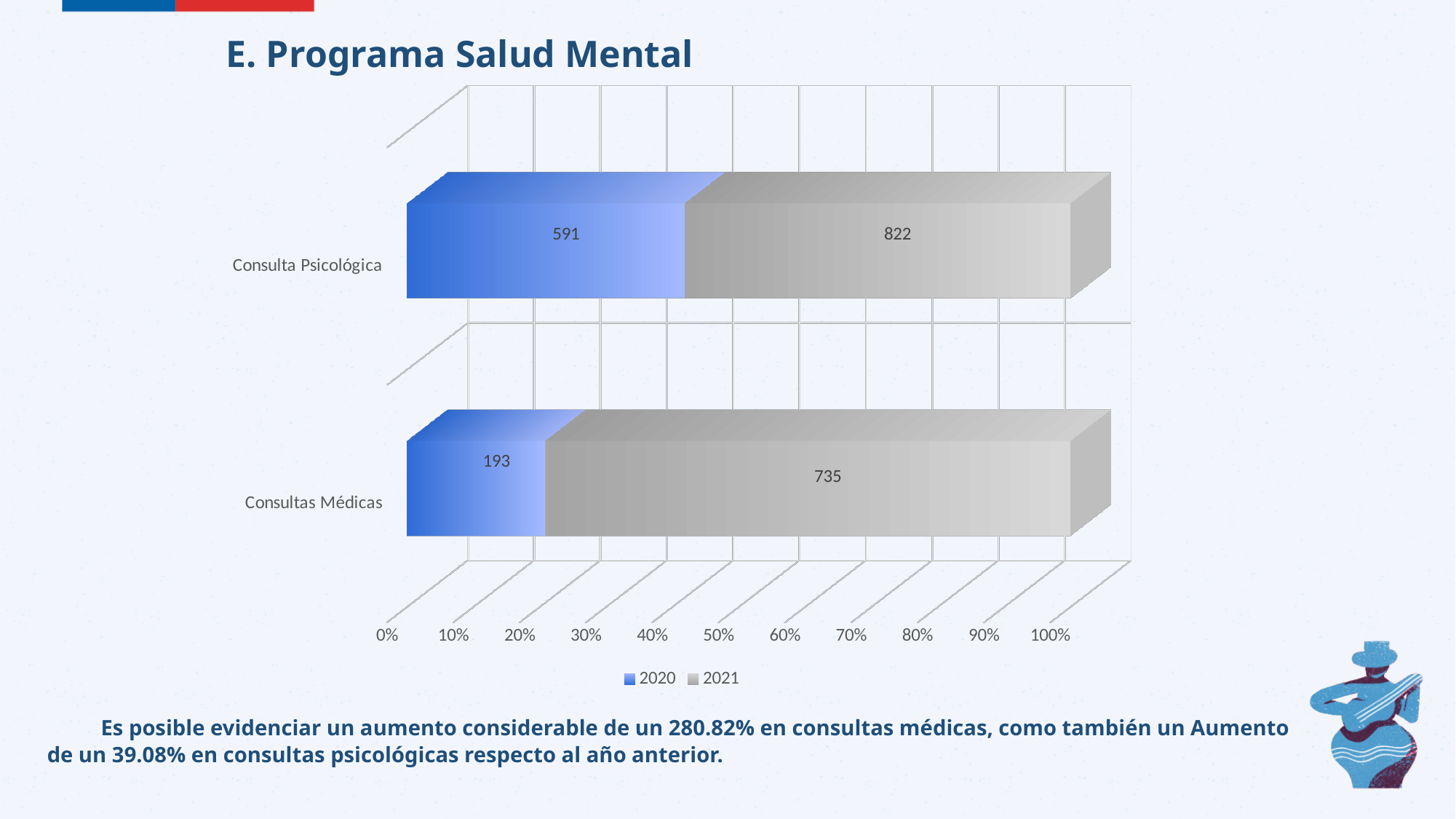
What is the difference between the 2021 and 2020 values for Consulta Psicológica? 231 What is the difference between the 2021 and 2020 values for Consultas Médicas? 542 Which category has the higher 2020 value? Consulta Psicológica Is the 2020 value for Consultas Médicas larger or smaller than the 2021 value for Consultas Médicas? smaller What is the 2021 value for Consulta Psicológica? 822 What kind of chart is shown on the slide? bar chart Which category has the lower 2021 value? Consultas Médicas What is the 2021 value for Consultas Médicas? 735 How many series does the legend list? 2 How many categories are shown on the chart? 2 What is the 2020 value for Consulta Psicológica? 591 What is the 2020 value for Consultas Médicas? 193